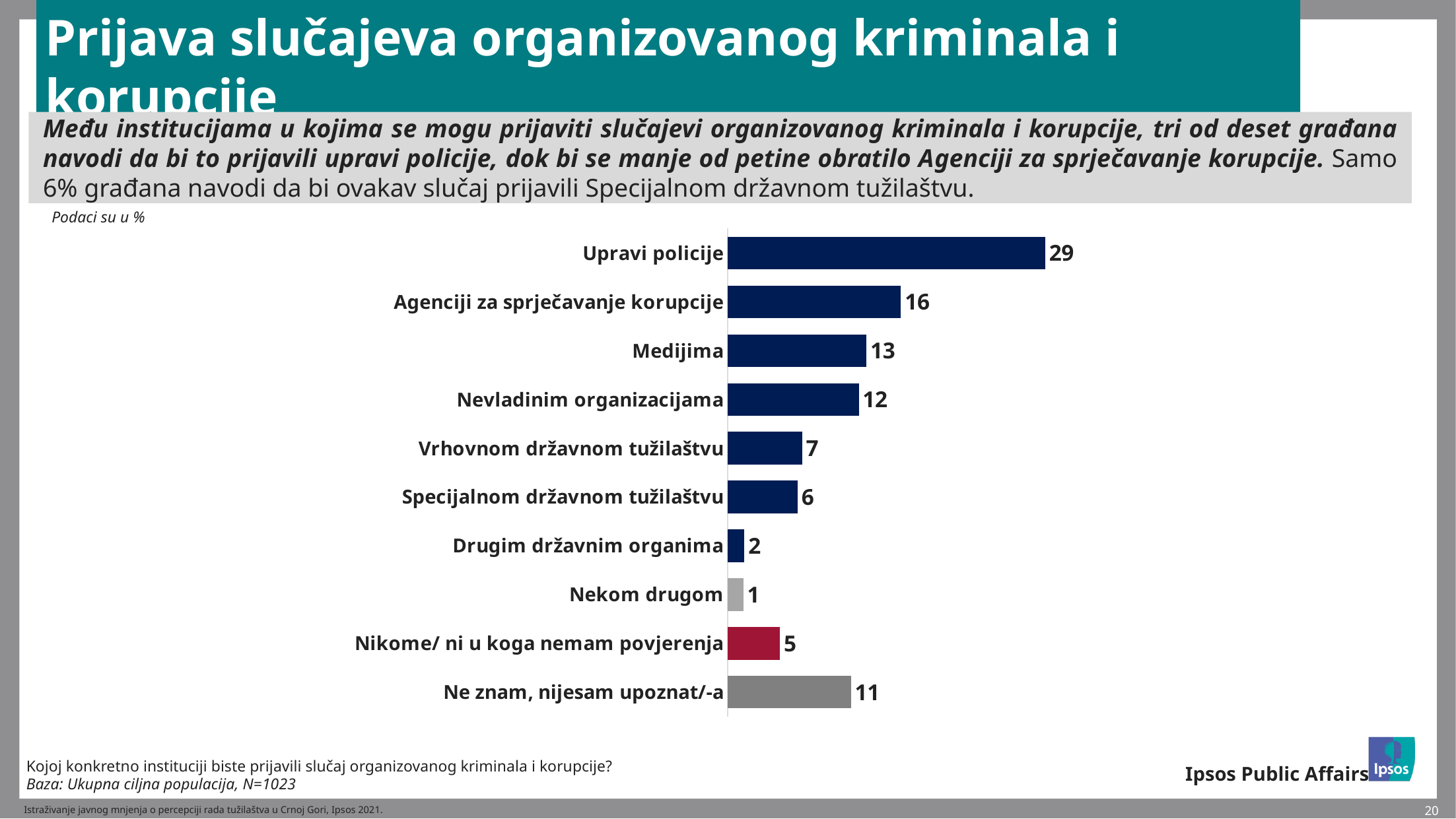
What is the value for Specijalnom državnom tužilaštvu? 6 How many categories are shown in the chart? 10 What is the value for Ne znam, nijesam upoznat/-a? 11 What is the difference between the values for Upravi policije and Agenciji za sprječavanje korupcije? 13 What kind of chart is shown on the slide? Bar chart What is the value for Upravi policije? 29 Which category has the lowest value? Nekom drugom Which category has the highest value? Upravi policije What is the value for Agenciji za sprječavanje korupcije? 16 Which is larger, the value for Medijima or the value for Nevladinim organizacijama? Medijima What is the difference between the values for Vrhovnom državnom tužilaštvu and Specijalnom državnom tužilaštvu? 1 What colour is the bar for Nikome/ ni u koga nemam povjerenja? Red